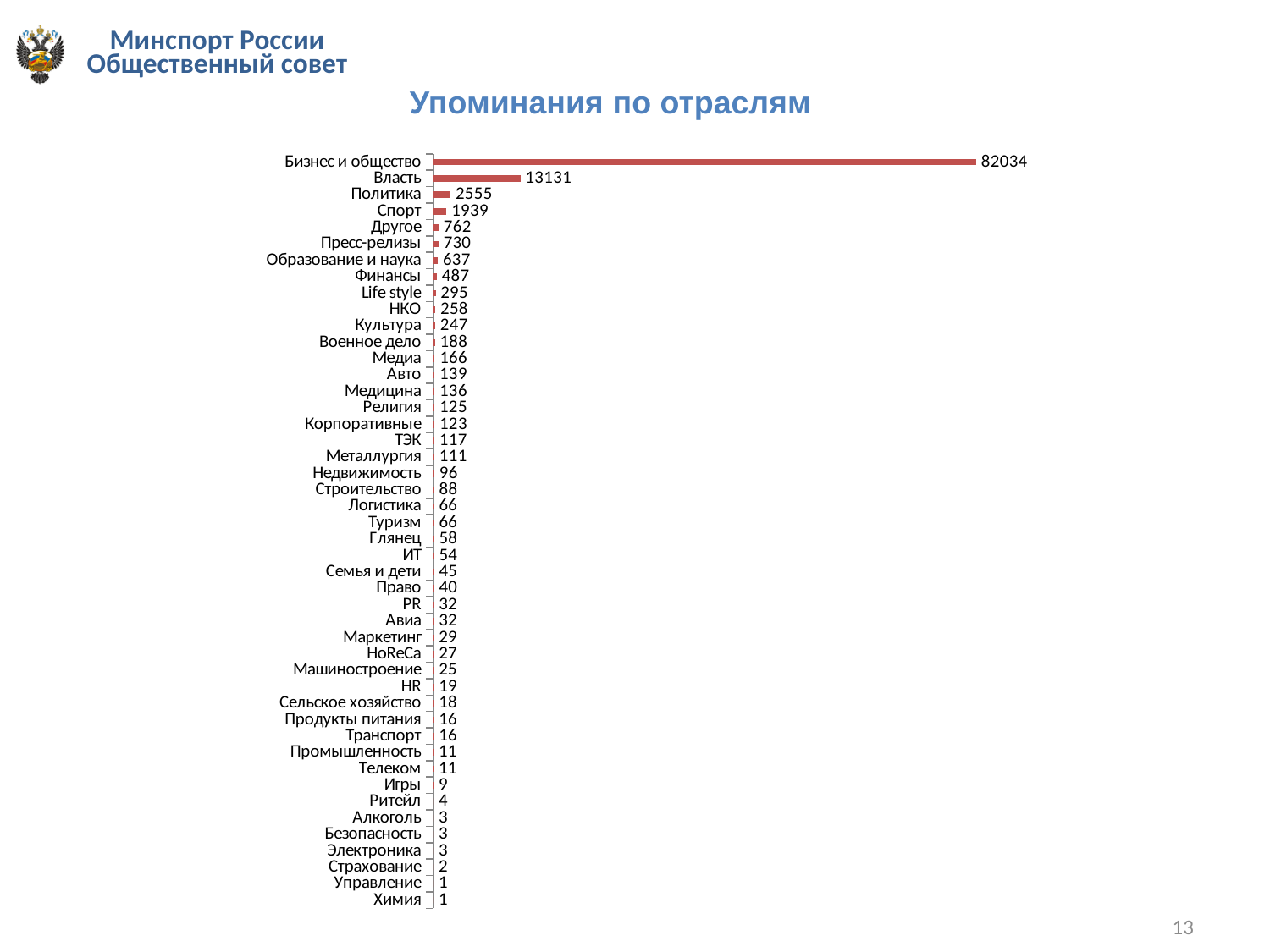
Which is larger, the value for Медиа or the value for Культура? Культура How many categories are shown in the chart? 46 What is the difference between the values for Власть and Политика? 10576 Which is larger, the value for Финансы or the value for Life style? Финансы What is the value for Власть? 13131 What is the value for Спорт? 1939 What is the difference between the values for Другое and Пресс-релизы? 32 What is the title of the chart? Упоминания по отраслям Which category has the highest value? Бизнес и общество What kind of chart is shown on the slide? Bar chart What is the value for Образование и наука? 637 What is the value for Бизнес и общество? 82034